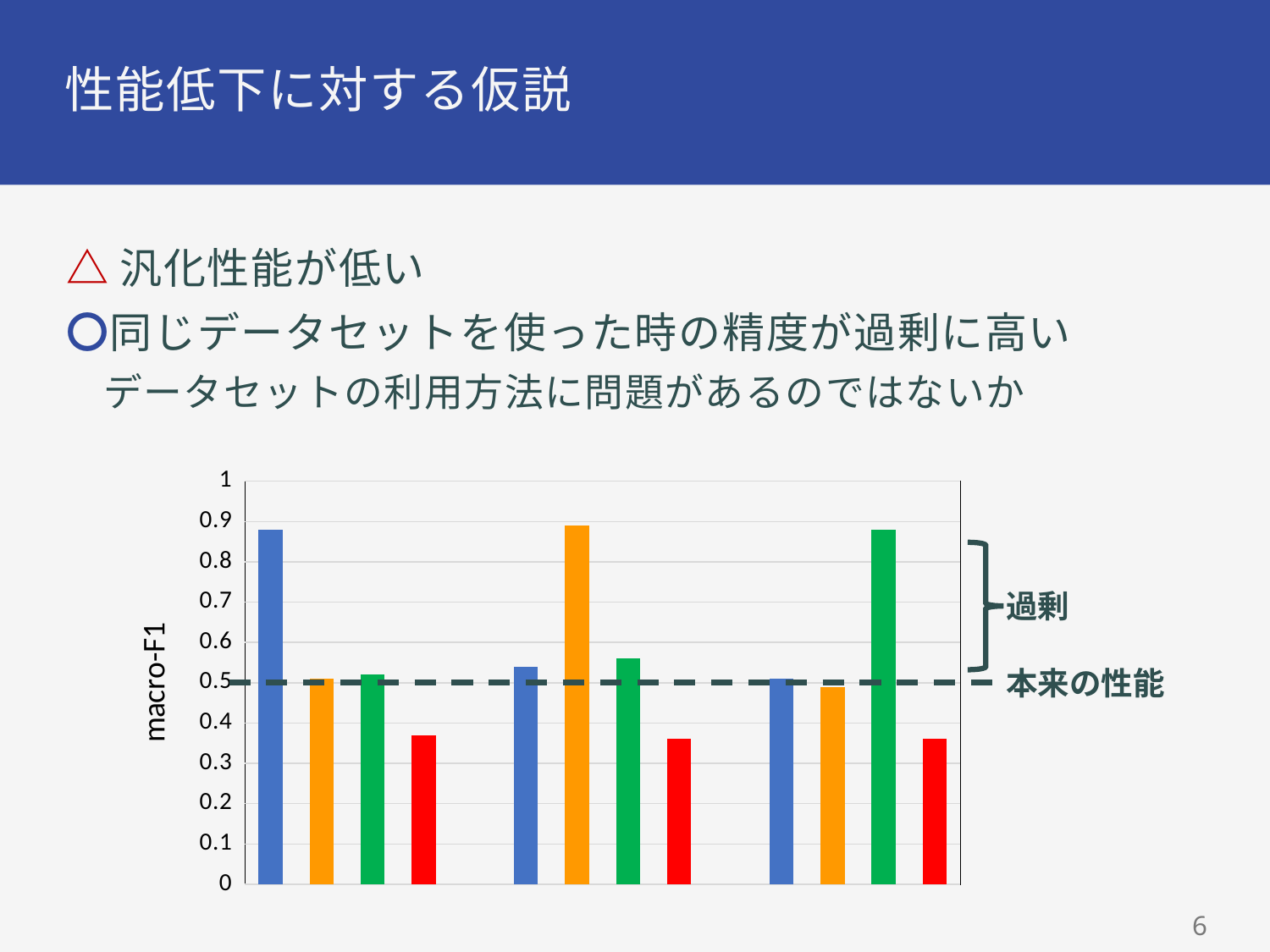
Is the value of the red bar in the leftmost group greater or less than 0.5? less Which colour bar is the lowest within the rightmost group? red What is the label on the vertical axis of the chart? macro-F1 Is the value of the green bar in the rightmost group greater or less than 0.8? greater How many bars are plotted in the chart in total? 12 Is the value of the orange bar in the middle group greater or less than 0.8? greater Which colour bar is the highest within the middle group? orange What label is attached to the horizontal dashed line in the chart? 本来の性能 How many groups of bars does the chart contain? 3 What kind of chart is shown on the slide? bar chart How many bars are in each group of the chart? 4